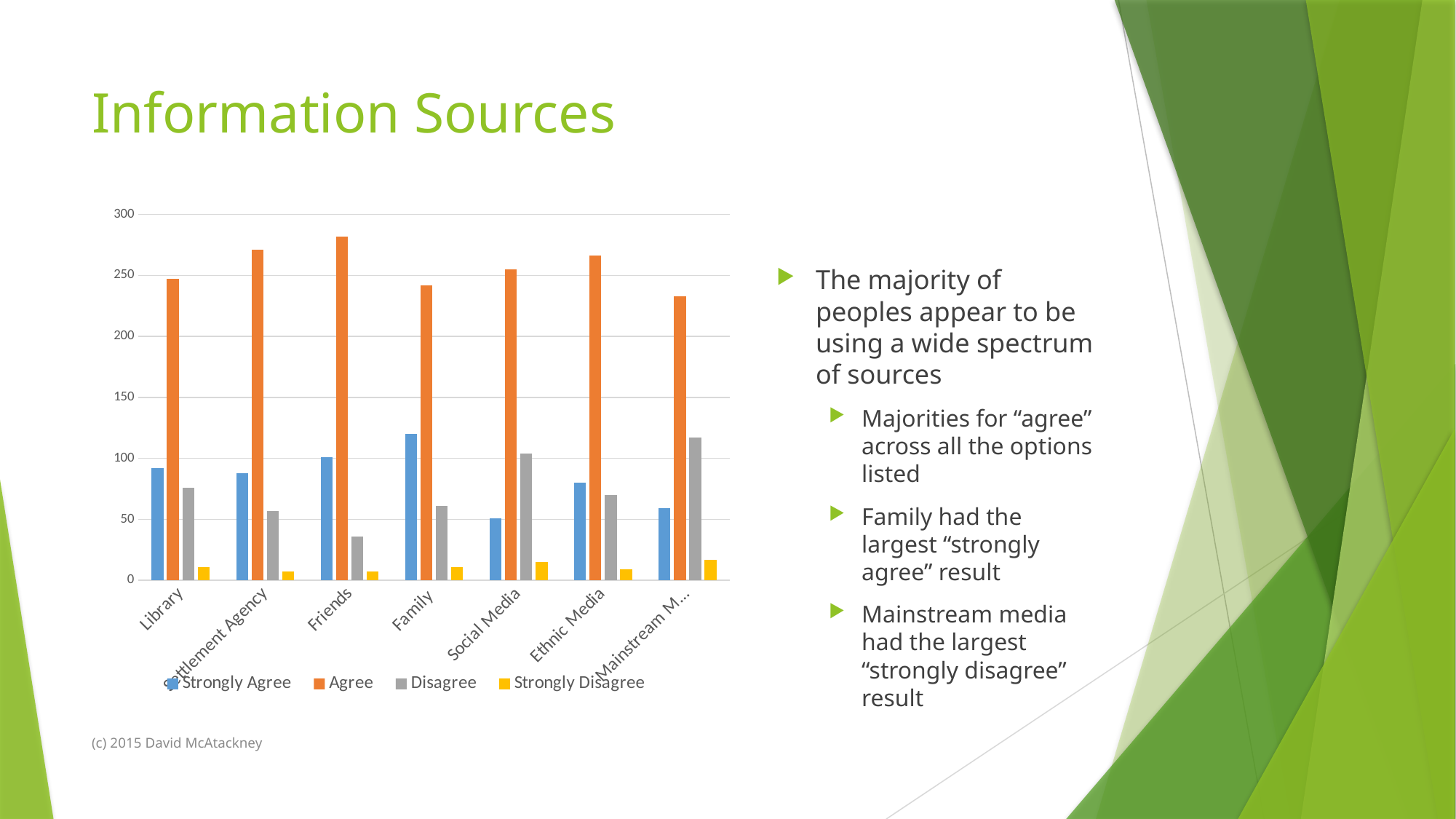
Is the Disagree value for Friends greater or less than 50? less Which is larger, the Disagree value for Library or the Disagree value for Family? Library Which category has the highest Agree value? Friends Which category has the highest Strongly Agree value? Family Is the Agree value for Library greater or less than 200? greater What kind of chart is shown on the slide? bar chart Which colour represents the Agree series in the chart? orange Which category has the lowest Disagree value? Friends How many series does the chart's legend list? 4 How many categories are shown along the x axis of the chart? 7 What is the title of the slide containing the chart? Information Sources Is the Strongly Agree value for Family greater or less than 100? greater